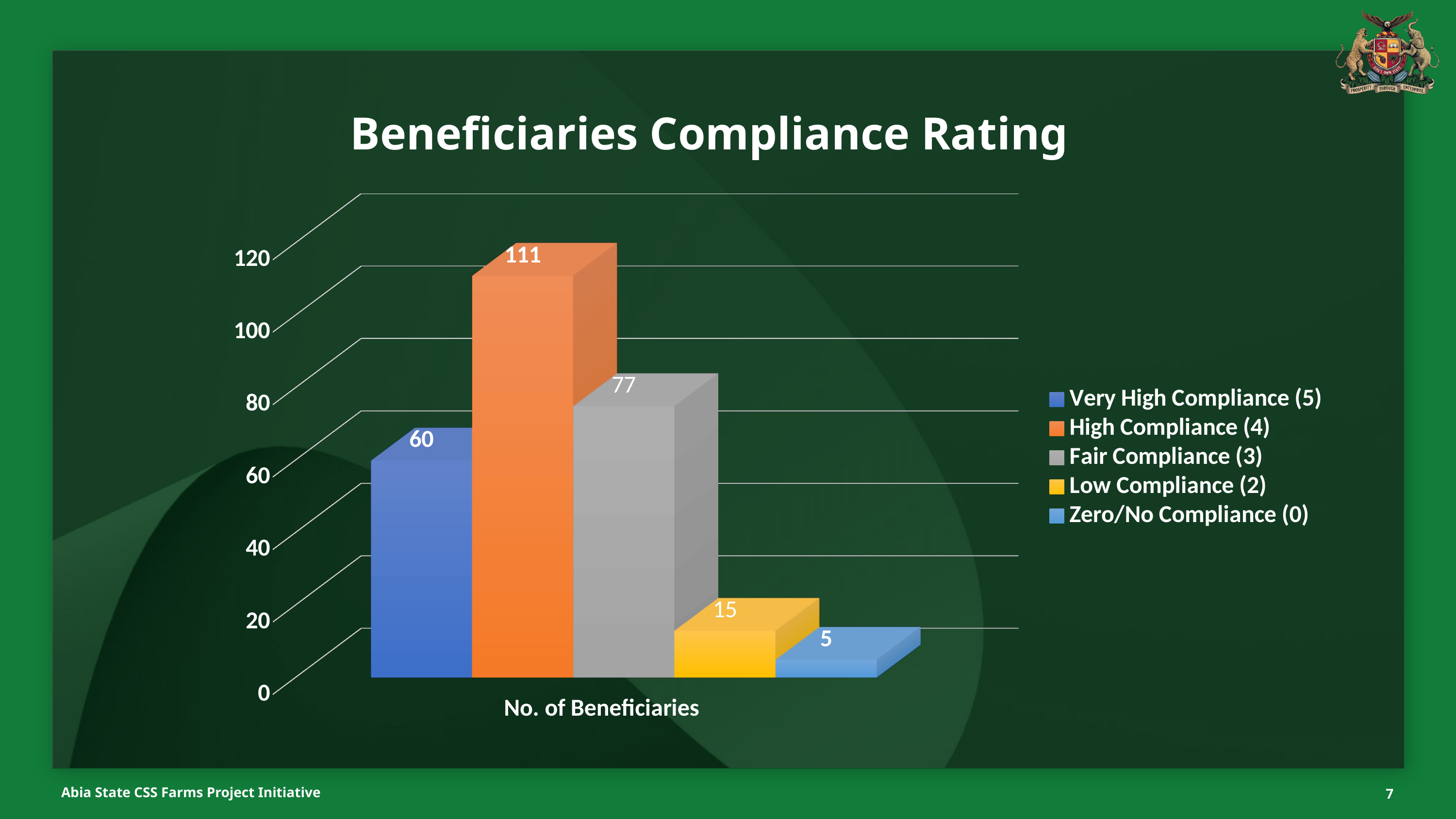
What is the number of beneficiaries with High Compliance (4)? 111 What is the number of beneficiaries with Very High Compliance (5)? 60 What is the title of the chart? Beneficiaries Compliance Rating What is the number of beneficiaries with Low Compliance (2)? 15 How many series does the legend list? 5 Which compliance category has the lowest number of beneficiaries? Zero/No Compliance (0) Which compliance category has the highest number of beneficiaries? High Compliance (4) Which has more beneficiaries, Very High Compliance (5) or Fair Compliance (3)? Fair Compliance (3) What kind of chart is shown on the slide? Bar chart What is the number of beneficiaries with Fair Compliance (3)? 77 What is the number of beneficiaries with Zero/No Compliance (0)? 5 What is the difference between the number of beneficiaries with High Compliance (4) and Fair Compliance (3)? 34